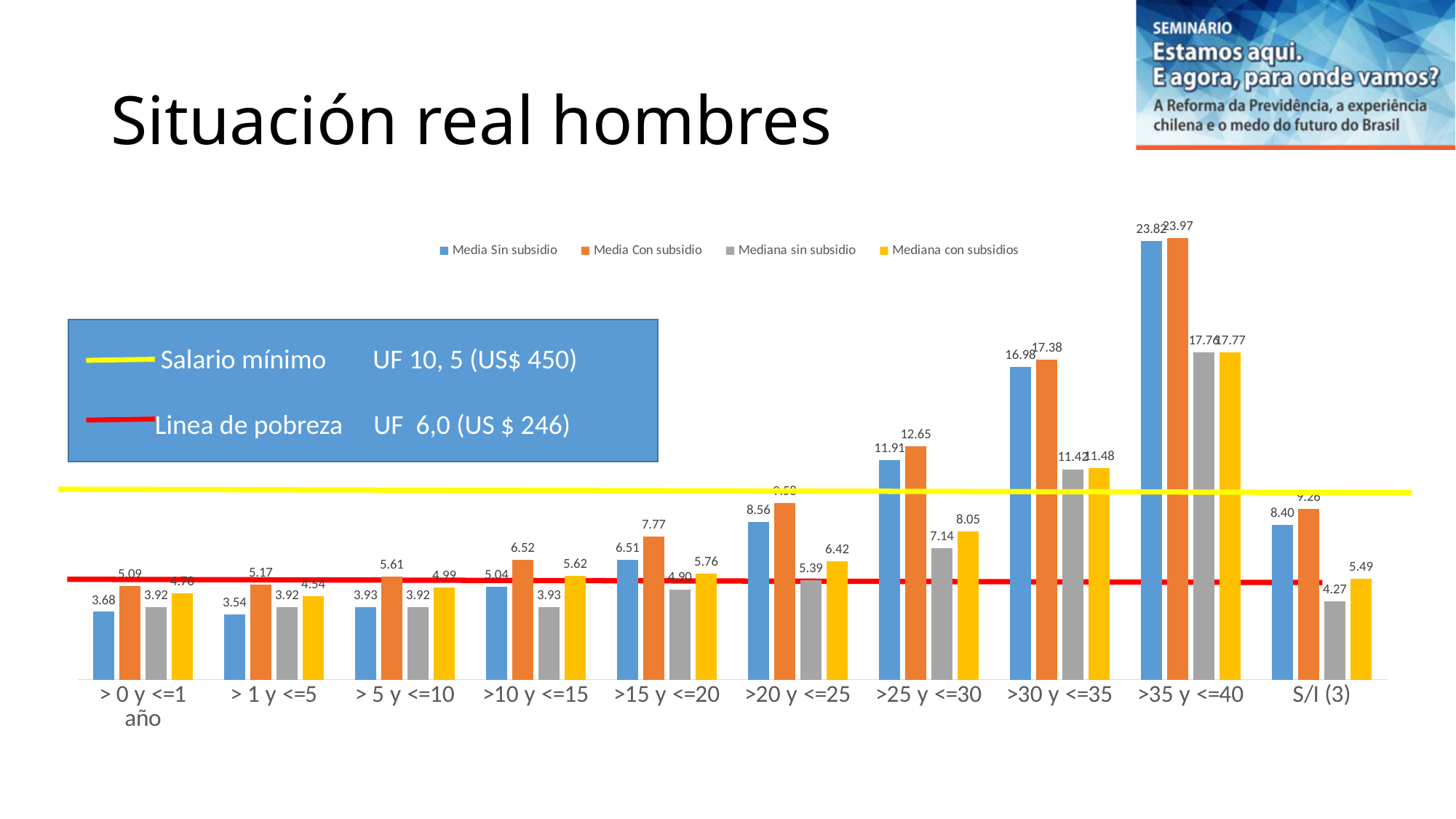
Which category has the lowest value for Media Sin subsidio? > 1 y <=5 For the category >10 y <=15, which is larger: Media Con subsidio or Mediana con subsidios? Media Con subsidio Which category has the highest value for Media Con subsidio? >35 y <=40 What type of chart is shown on the slide? bar chart What is the difference between Media Con subsidio and Media Sin subsidio for the category >30 y <=35? 0.40 Does the value of Media Sin subsidio generally rise or fall from > 0 y <=1 año to >35 y <=40? rise How many categories are shown on the x axis of the chart? 10 What is the value of Mediana sin subsidio for the category >15 y <=20? 4.90 According to the legend box on the slide, what value in UF does the yellow line (Salario mínimo) represent? UF 10, 5 (US$ 450) What is the value of Media Sin subsidio for the category S/I (3)? 8.40 How many series does the chart legend list? 4 What is the value of Media Con subsidio for the category >25 y <=30? 12.65